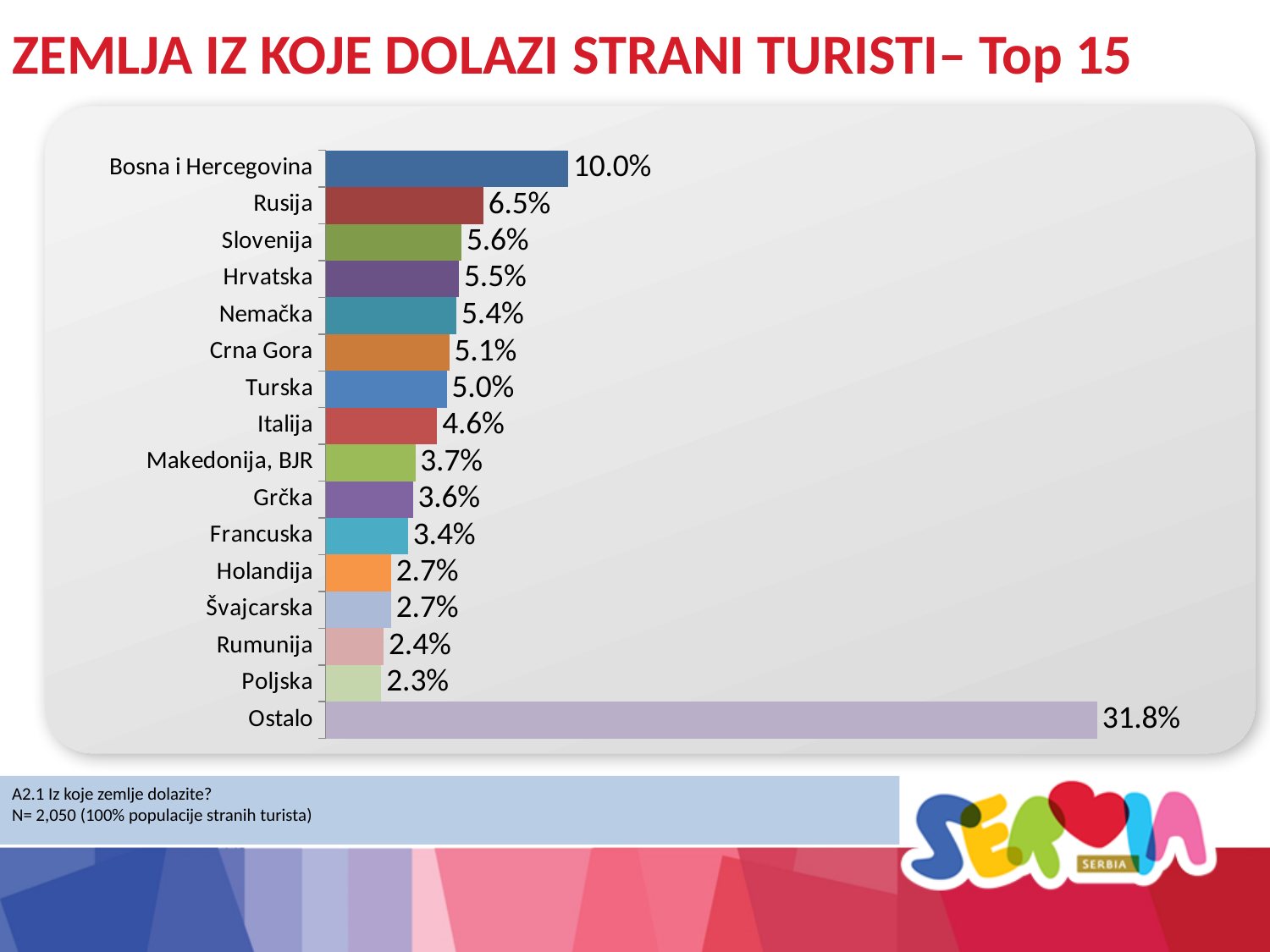
What kind of chart is shown on the slide? Bar chart How many categories are shown in the chart? 16 Which category has the highest value? Ostalo What is the difference between the values for Ostalo and Poljska? 29.5% Which named country has the lowest value? Poljska What is the value for Ostalo? 31.8% Which is larger, the value for Slovenija or the value for Hrvatska? Slovenija What is the value for Rusija? 6.5% What is the title of the slide? ZEMLJA IZ KOJE DOLAZI STRANI TURISTI– Top 15 What is the difference between the values for Bosna i Hercegovina and Rusija? 3.5% What is the value for Francuska? 3.4% What is the value for Bosna i Hercegovina? 10.0%